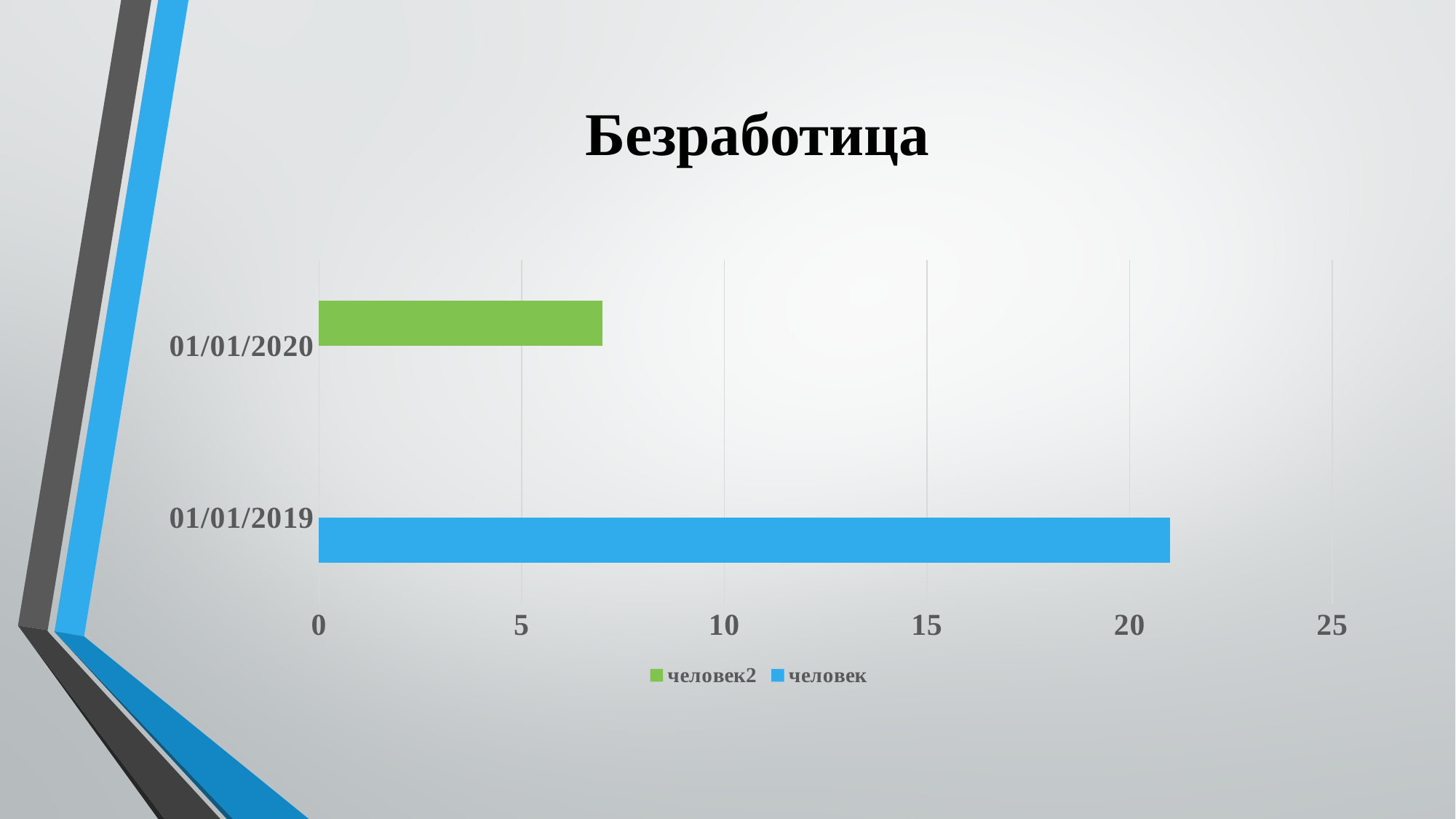
What is the title of the chart? Безработица Which category has the lowest value? 01/01/2020 Is the value for 01/01/2019 greater or less than 20? greater Is the value for 01/01/2019 greater or less than 25? less What kind of chart is shown on the slide? bar chart Is the value for 01/01/2020 greater or less than 5? greater Which legend entry is shown in green? человек2 How many series does the legend list? 2 How many categories are shown on the chart? 2 Which is larger, the value for 01/01/2019 or the value for 01/01/2020? 01/01/2019 Which category has the highest value? 01/01/2019